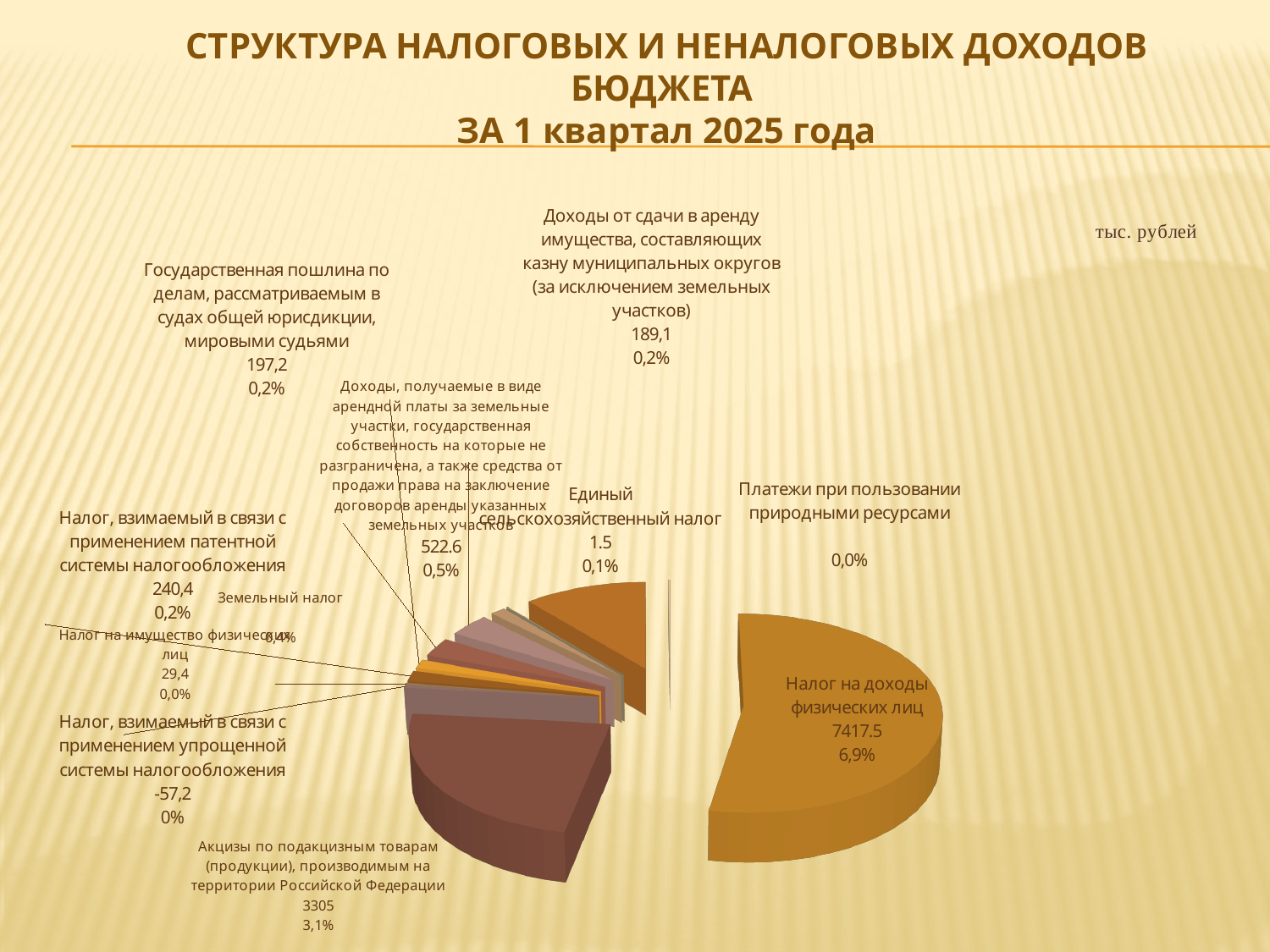
What is the value shown for Налог, взимаемый в связи с применением упрощенной системы налогообложения? -57,2 What is the value shown for Единый сельскохозяйственный налог? 1.5 What percentage is shown for Налог на доходы физических лиц? 6,9% What kind of chart is shown on the slide? Pie chart What is the value shown for Налог на доходы физических лиц? 7417.5 Which is larger: the value for Акцизы по подакцизным товарам or the value for Государственная пошлина? Акцизы по подакцизным товарам Which category has the largest slice of the pie? Налог на доходы физических лиц What is the value shown for Государственная пошлина по делам, рассматриваемым в судах общей юрисдикции, мировыми судьями? 197,2 In what units are the values on the chart expressed, according to the slide? тыс. рублей What percentage is shown for Акцизы по подакцизным товарам (продукции), производимым на территории Российской Федерации? 3,1% What is the value shown for Акцизы по подакцизным товарам (продукции), производимым на территории Российской Федерации? 3305 What is the difference between the values for Налог на доходы физических лиц and Акцизы по подакцизным товарам? 4112.5